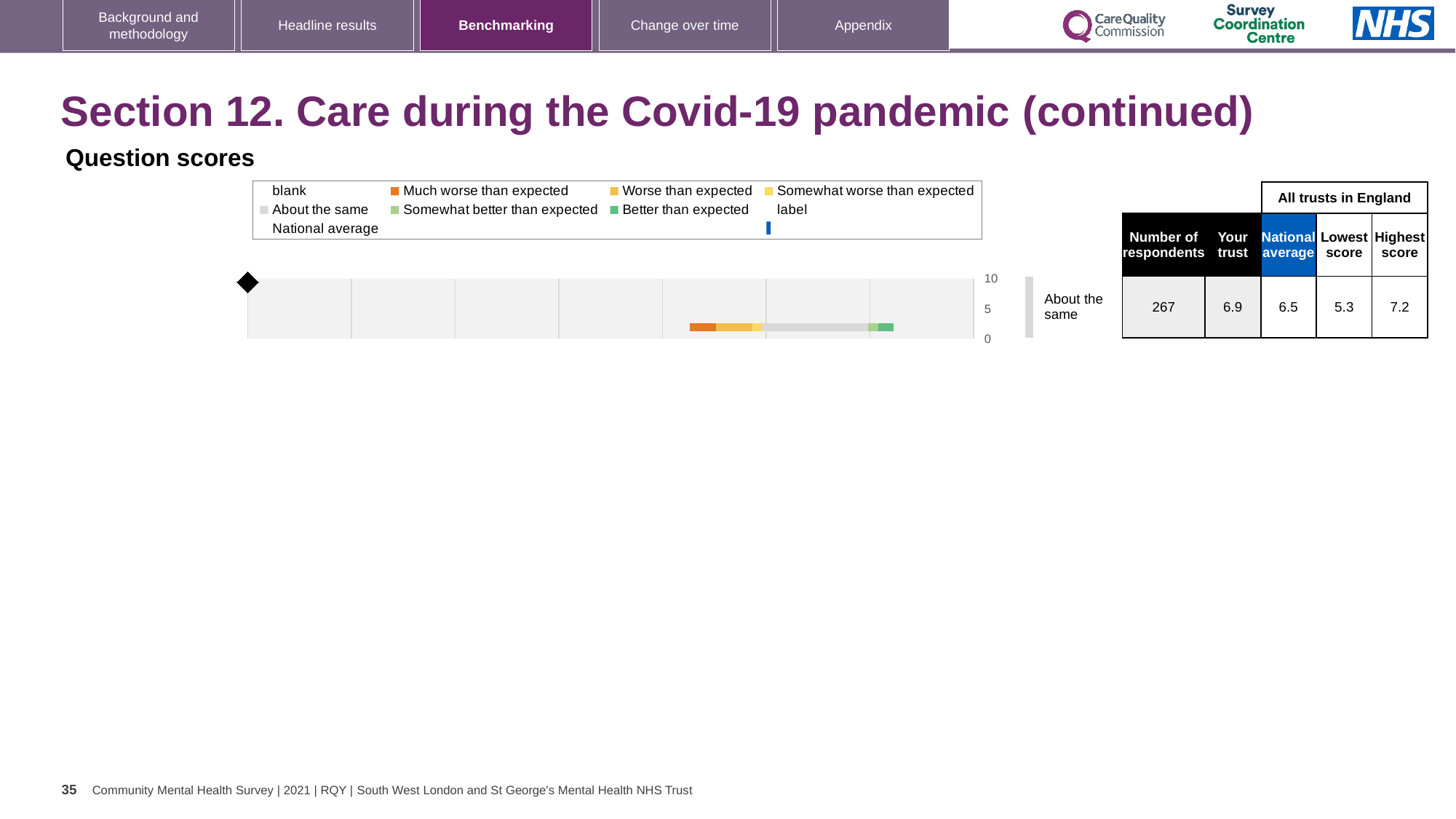
What is the benchmark category label shown next to the bar? About the same In the table beside the chart, what is the highest score among all trusts in England? 7.2 What is the highest tick value shown on the chart's axis? 10 In the table beside the chart, what is the number of respondents? 267 What is the difference between the highest score and the lowest score in the table? 1.9 Which is larger, the 'Your trust' score or the national average? Your trust In the table beside the chart, what is the 'Your trust' score? 6.9 How many bars (question rows) are plotted in the chart? 1 In the table beside the chart, what is the lowest score among all trusts in England? 5.3 In the table beside the chart, what is the national average score? 6.5 What kind of chart is shown under 'Question scores'? bar chart What colour does the legend use for 'Much worse than expected'? orange